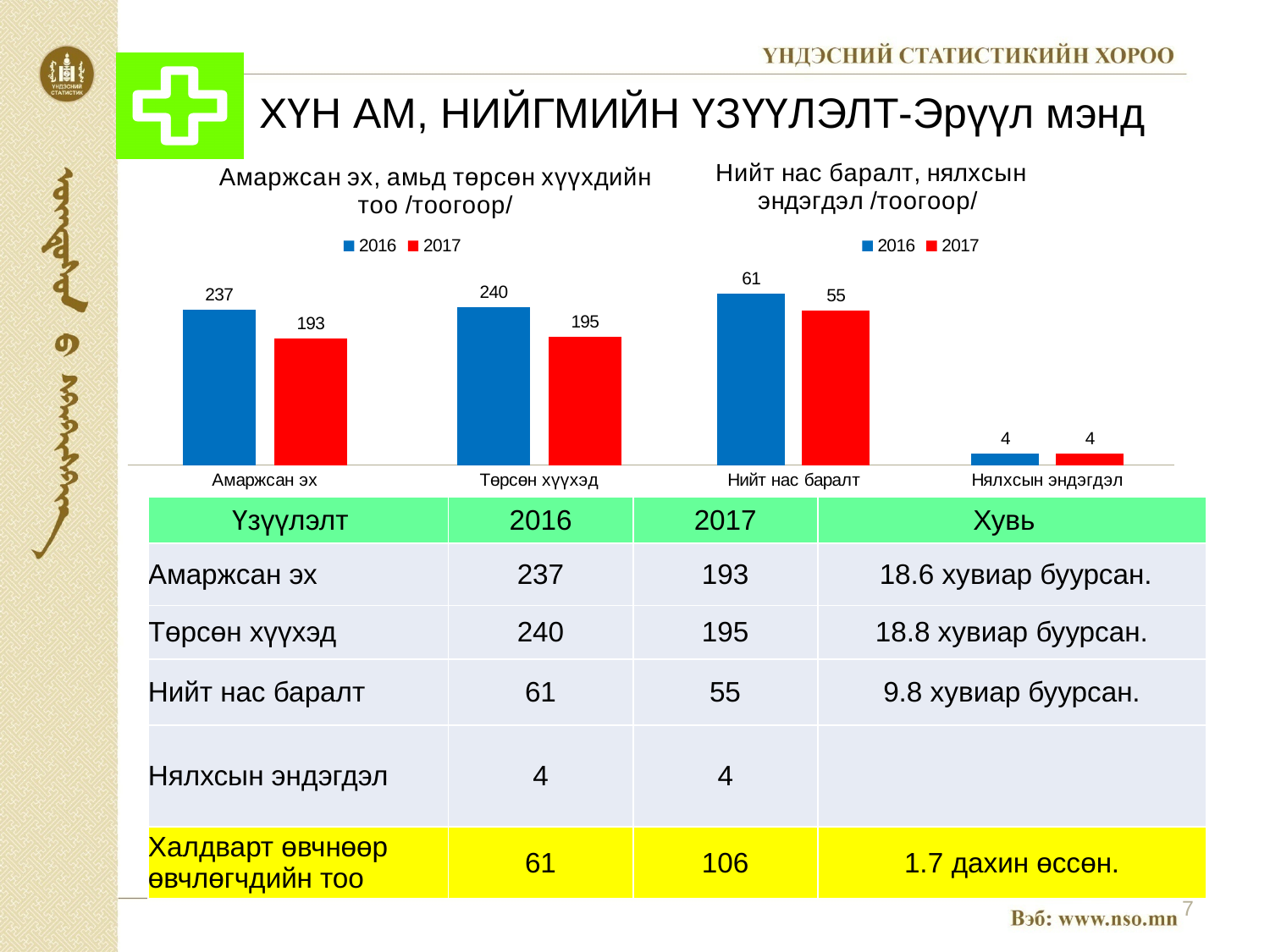
How many series does the legend of the right chart list? 2 How many categories are shown on the x axis of the left chart? 2 In the left chart (Амаржсан эх, амьд төрсөн хүүхдийн тоо), what is the 2016 value for Амаржсан эх? 237 In the left chart, which bar is the highest? Төрсөн хүүхэд, 2016 In the left chart (Амаржсан эх, амьд төрсөн хүүхдийн тоо), what is the 2017 value for Төрсөн хүүхэд? 195 In the right chart (Нийт нас баралт, нялхсын эндэгдэл), what is the 2017 value for Нийт нас баралт? 55 In the left chart, what is the difference between the 2016 and 2017 values for Амаржсан эх? 44 In the right chart (Нийт нас баралт, нялхсын эндэгдэл), what is the 2016 value for Нялхсын эндэгдэл? 4 In the right chart, which category has the lowest values? Нялхсын эндэгдэл In the right chart, what is the difference between the 2016 and 2017 values for Нийт нас баралт? 6 In the left chart, which is larger: the 2016 value for Төрсөн хүүхэд or the 2017 value for Төрсөн хүүхэд? 2016 What type of chart is the right chart (Нийт нас баралт, нялхсын эндэгдэл)? Bar chart